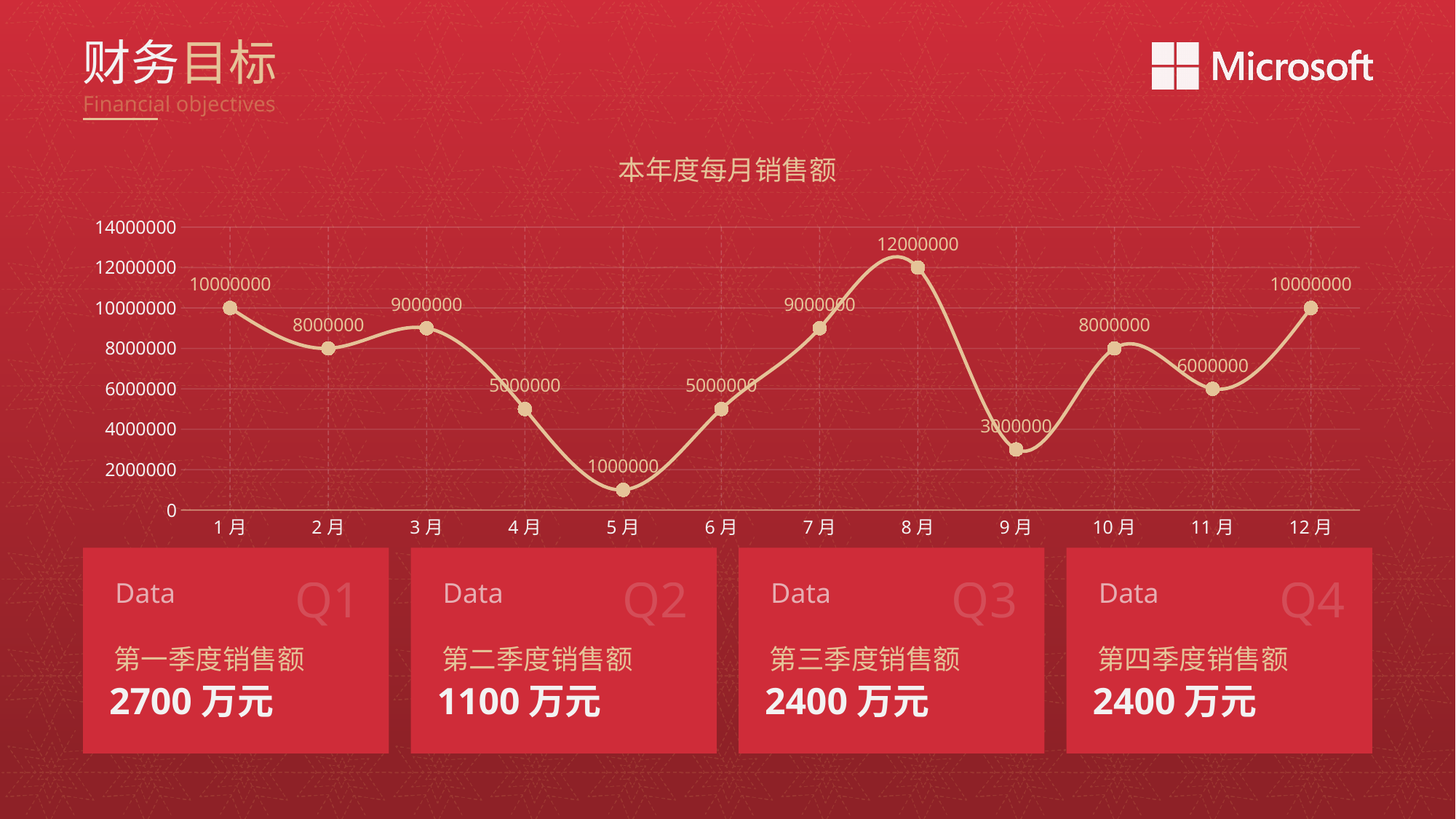
Does the value rise or fall from 9月 to 10月? rise How many months are plotted on the x axis? 12 Which month has the lowest value? 5月 What is the title of the chart? 本年度每月销售额 What is the value for 5月? 1000000 What is the difference between the values for 8月 and 9月? 9000000 What is the value for 11月? 6000000 What type of chart is shown on the slide? line chart Which month has the highest value? 8月 Which is larger, the value for 2月 or the value for 3月? 3月 What is the value for 8月? 12000000 What is the difference between the values for 1月 and 4月? 5000000